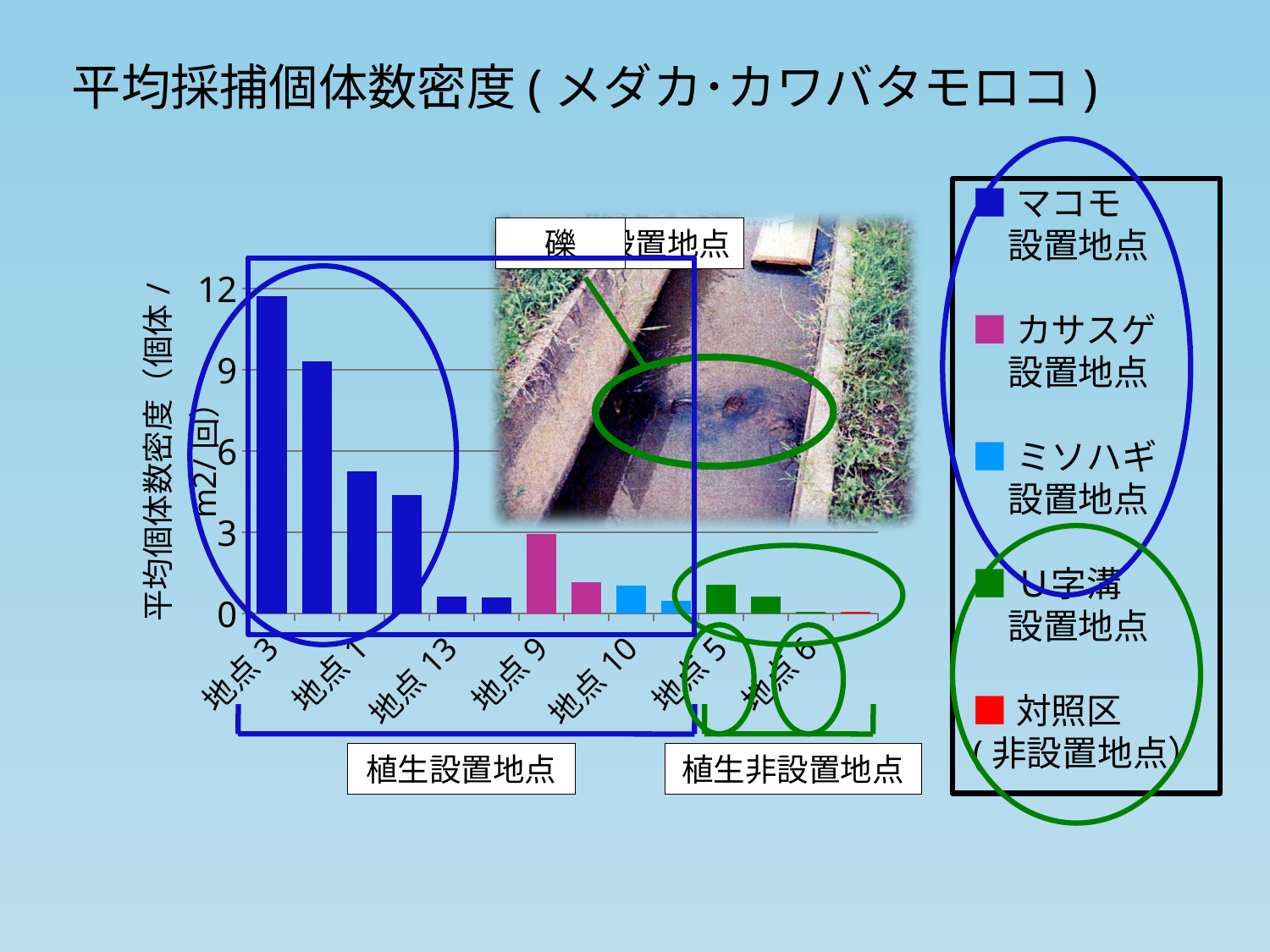
How many series does the legend list? 5 Is the value for 地点3 greater or less than 9? greater Is the value for 地点5 greater or less than 3? less Is the value for 地点1 greater or less than 3? greater Which labelled site has the highest average individual density? 地点3 Do the bar values generally rise or fall from left to right along the x axis? fall Which is larger, the value for 地点1 or the value for 地点9? 地点1 What kind of chart is shown on the slide? bar chart Which is larger, the value for 地点3 or the value for 地点1? 地点3 What colour does the legend use for カサスゲ設置地点? magenta (pink)